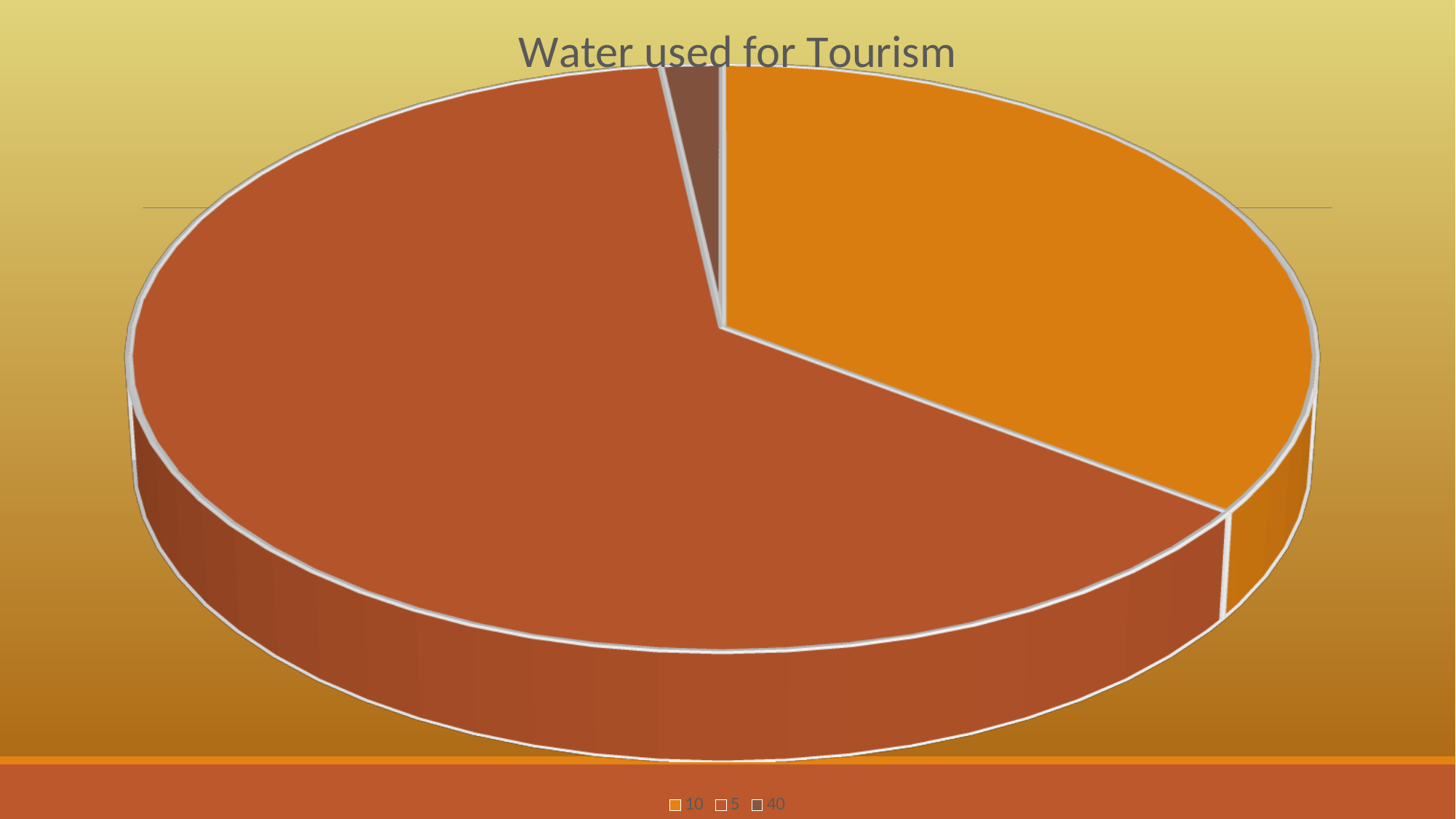
Which slice is larger, the one for category 40 or the one for category 10? 10 Which slice is larger, the one for category 10 or the one for category 5? 5 Which category has the largest slice of the pie? 5 How many slices does the pie chart have? 3 How many entries does the legend list? 3 What are the three legend entries shown below the chart? 10, 5, 40 Which category has the smallest slice of the pie? 40 What kind of chart is shown on the slide? pie chart What is the title of the chart? Water used for Tourism